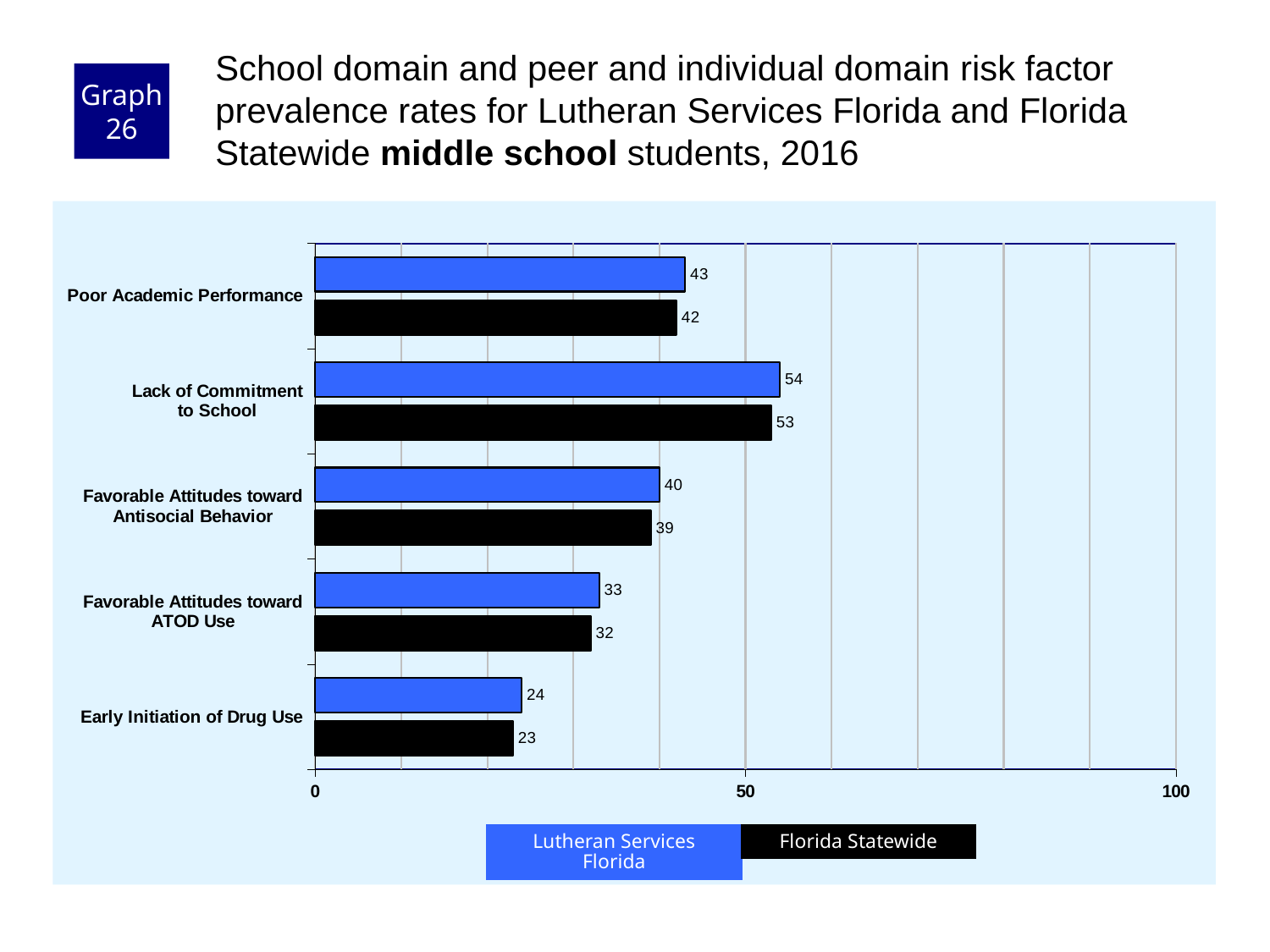
Which risk factor has the highest Lutheran Services Florida value? Lack of Commitment to School What is the Florida Statewide value for Favorable Attitudes toward ATOD Use? 32 Is the Florida Statewide value for Lack of Commitment to School greater or less than 50? greater What is the difference between the Lutheran Services Florida and Florida Statewide values for Poor Academic Performance? 1 What is the difference between the Lutheran Services Florida values for Lack of Commitment to School and Early Initiation of Drug Use? 30 How many risk factor categories are shown on the chart? 5 What kind of chart is shown on the slide? bar chart Which is larger: the Lutheran Services Florida value for Favorable Attitudes toward Antisocial Behavior or the Lutheran Services Florida value for Favorable Attitudes toward ATOD Use? Favorable Attitudes toward Antisocial Behavior What is the Florida Statewide value for Early Initiation of Drug Use? 23 What is the Lutheran Services Florida value for Lack of Commitment to School? 54 How many series does the legend list? 2 Which risk factor has the lowest Florida Statewide value? Early Initiation of Drug Use